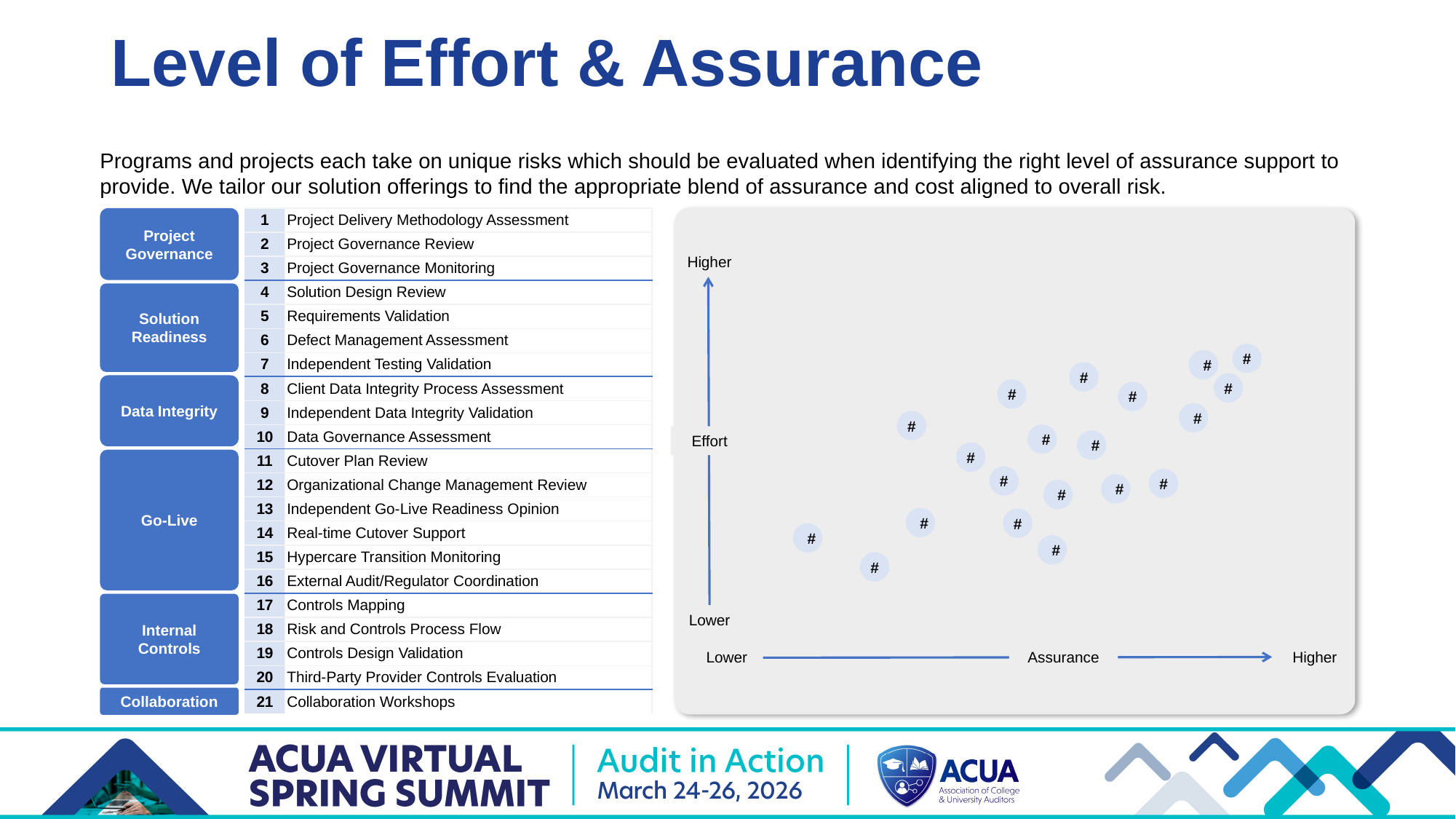
What does the vertical axis of the chart represent? Effort What does the horizontal axis of the chart represent? Assurance As assurance increases along the horizontal axis, do the plotted points generally rise or fall in effort? rise What kind of chart is shown on the right side of the slide? scatter chart